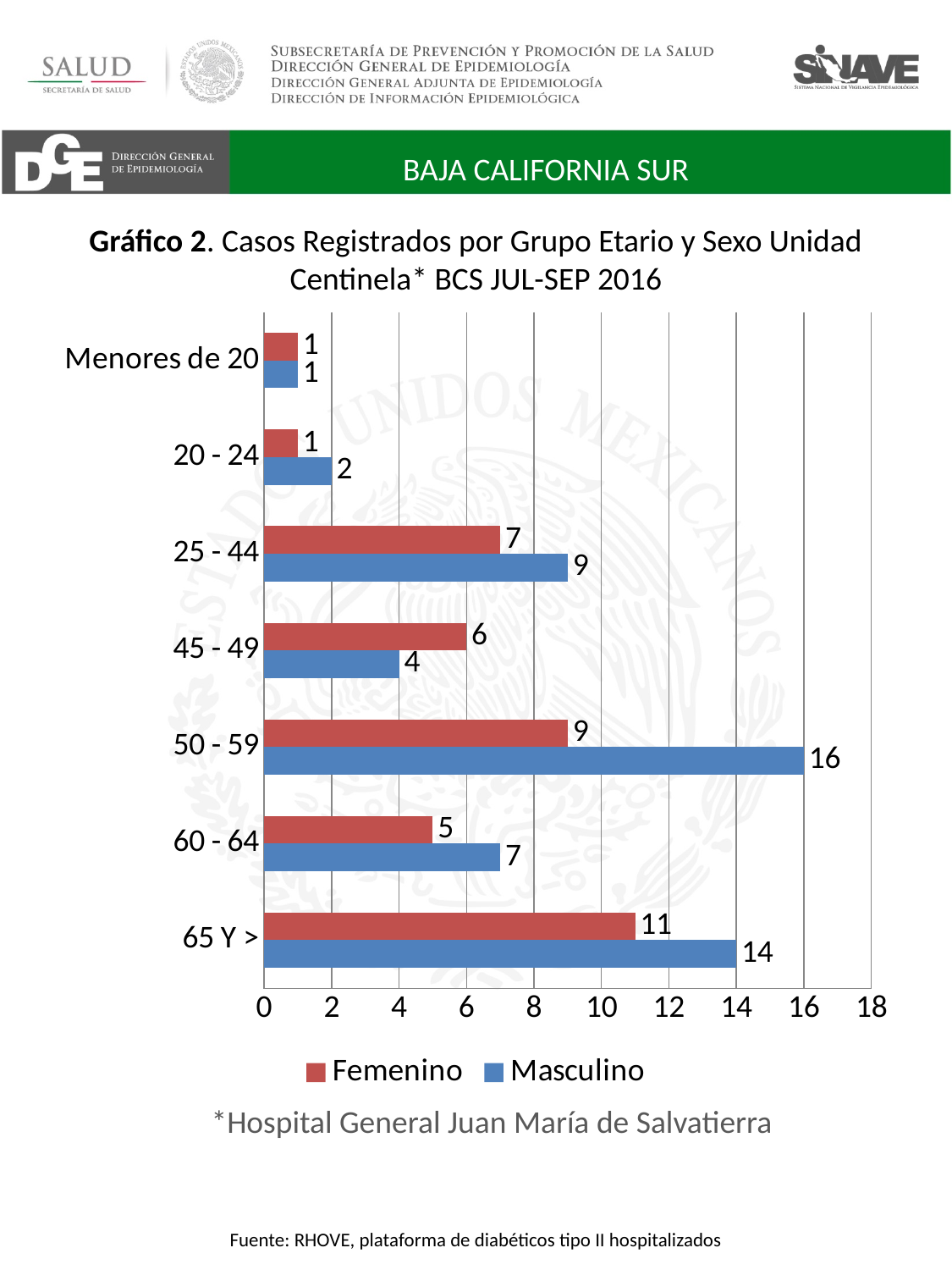
What is the total of Femenino and Masculino values for the 65 Y > age group? 25 What is the Femenino value for the 45 - 49 age group? 6 For the 45 - 49 age group, which is larger, Femenino or Masculino? Femenino How many series does the legend list? 2 What is the Masculino value for the 50 - 59 age group? 16 Which colour represents the Masculino series in the chart? Blue Which age group has the lowest Masculino value? Menores de 20 What is the difference between the Masculino and Femenino values for the 50 - 59 age group? 7 How many age groups are shown on the chart? 7 What is the Femenino value for the 65 Y > age group? 11 What kind of chart is shown on the slide? Bar chart Which age group has the highest Masculino value? 50 - 59